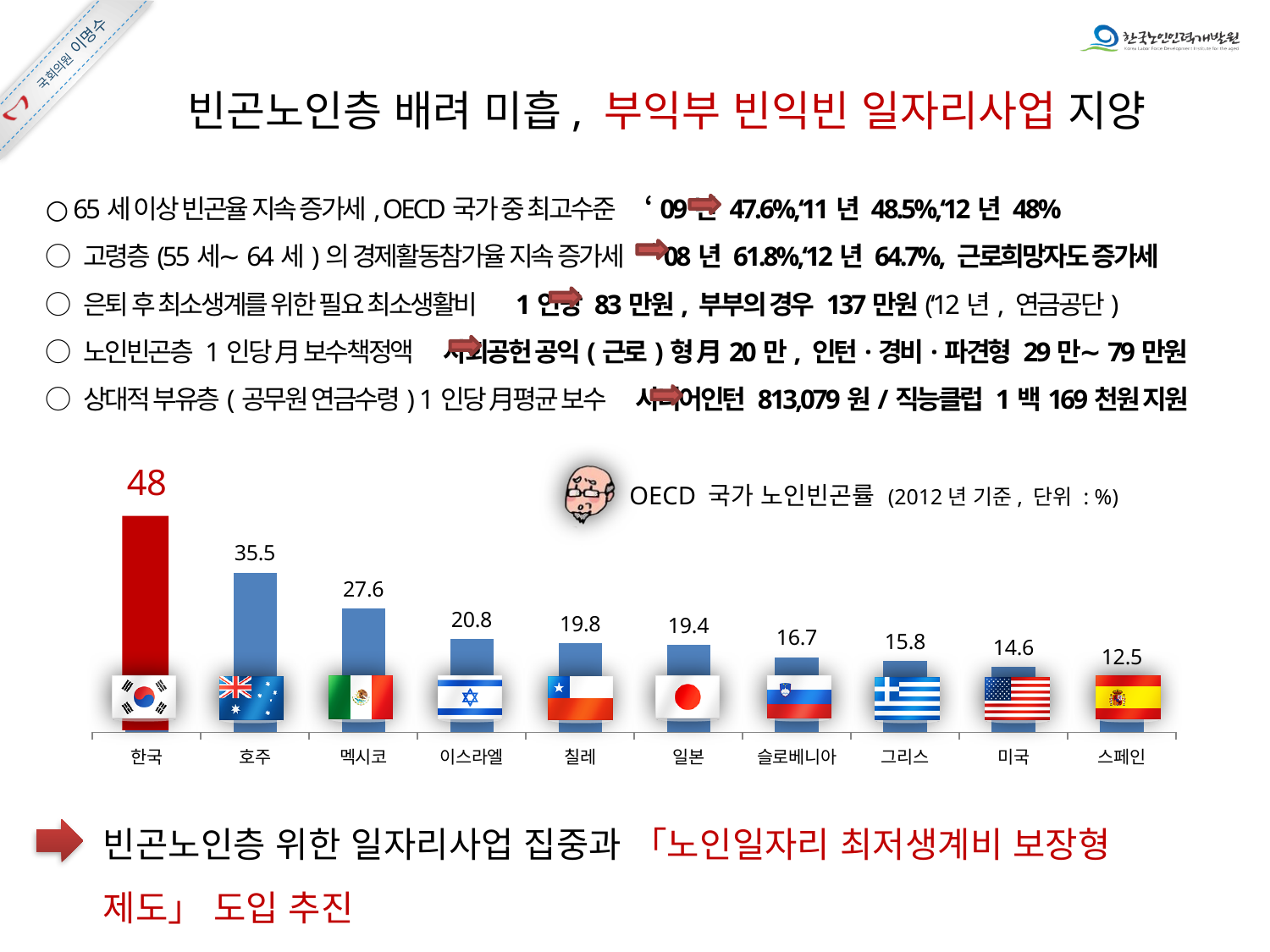
How many countries are shown in the chart? 10 What kind of chart is used to show the OECD elderly poverty rates? bar chart What is the elderly poverty rate shown for 한국 in the chart? 48 Which has a larger value, 이스라엘 or 그리스? 이스라엘 What value is shown for 일본 in the chart? 19.4 What value is shown for 호주 in the chart? 35.5 Which country has the highest value in the chart? 한국 Which country has the lowest value in the chart? 스페인 What is the difference between the values for 멕시코 and 스페인? 15.1 Do the values rise or fall moving from left to right across the chart? fall What value is shown for 미국 in the chart? 14.6 What is the difference between the values for 한국 and 호주? 12.5